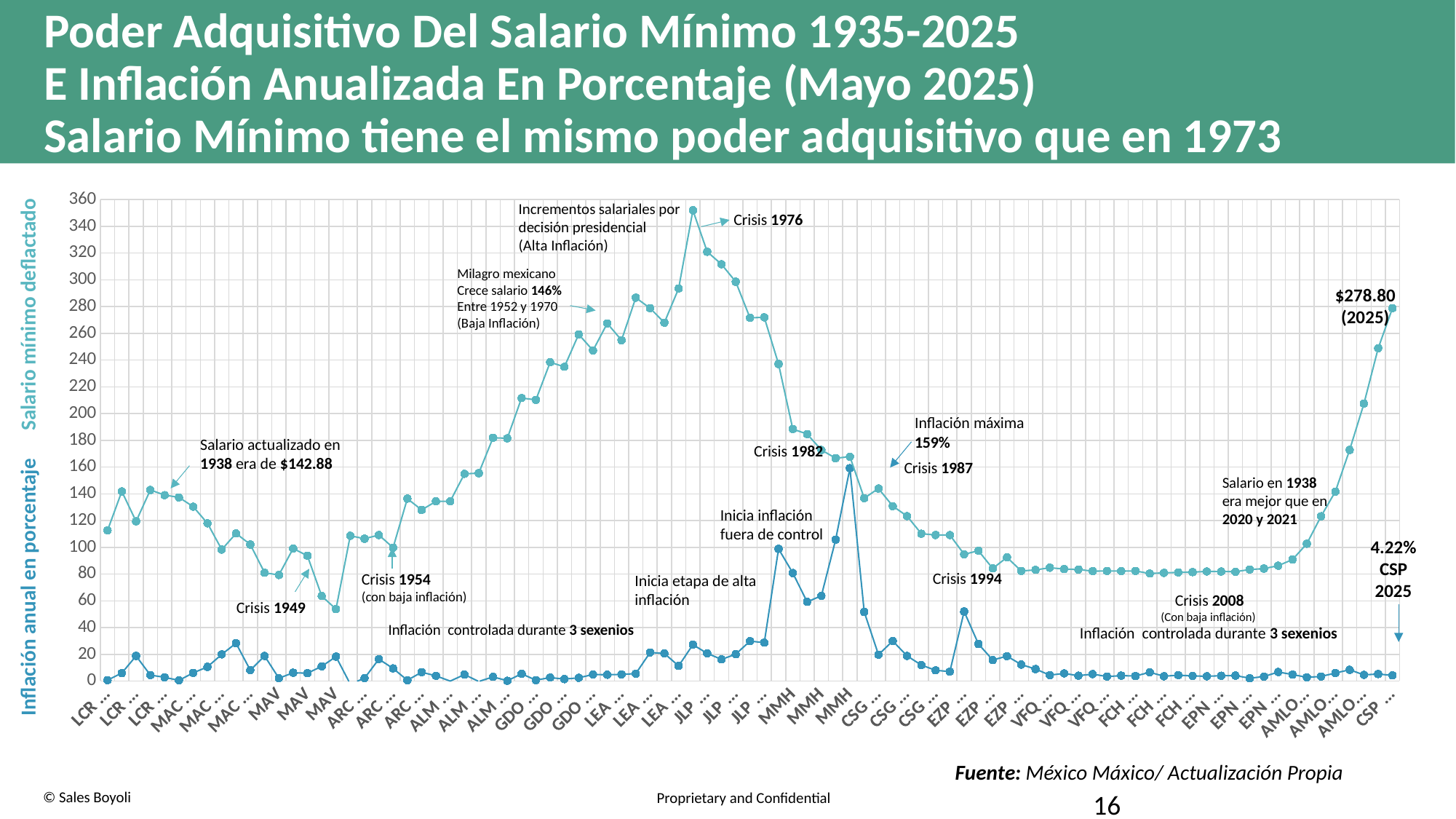
What is the difference between the 2025 deflated minimum wage ($278.80) and the 1938 value ($142.88)? $135.92 Which is larger, the deflated minimum wage in 2025 or in 1938? 2025 What kind of chart is shown on the slide? line chart What is the deflated minimum wage value labelled for 2025? $278.80 What is the maximum inflation value annotated on the chart? 159% How many data series are plotted on the chart? 2 According to the annotation, what was the updated minimum wage in 1938? $142.88 Which crisis annotation marks the highest point of the deflated minimum wage line? Crisis 1976 What annual inflation percentage is labelled for CSP 2025? 4.22% Is the peak value of the deflated minimum wage line at Crisis 1976 greater or less than 340? greater What is the source cited for the chart? México Máxico/ Actualización Propia Does the deflated minimum wage line rise or fall from the 1976 peak to the 1990s? fall